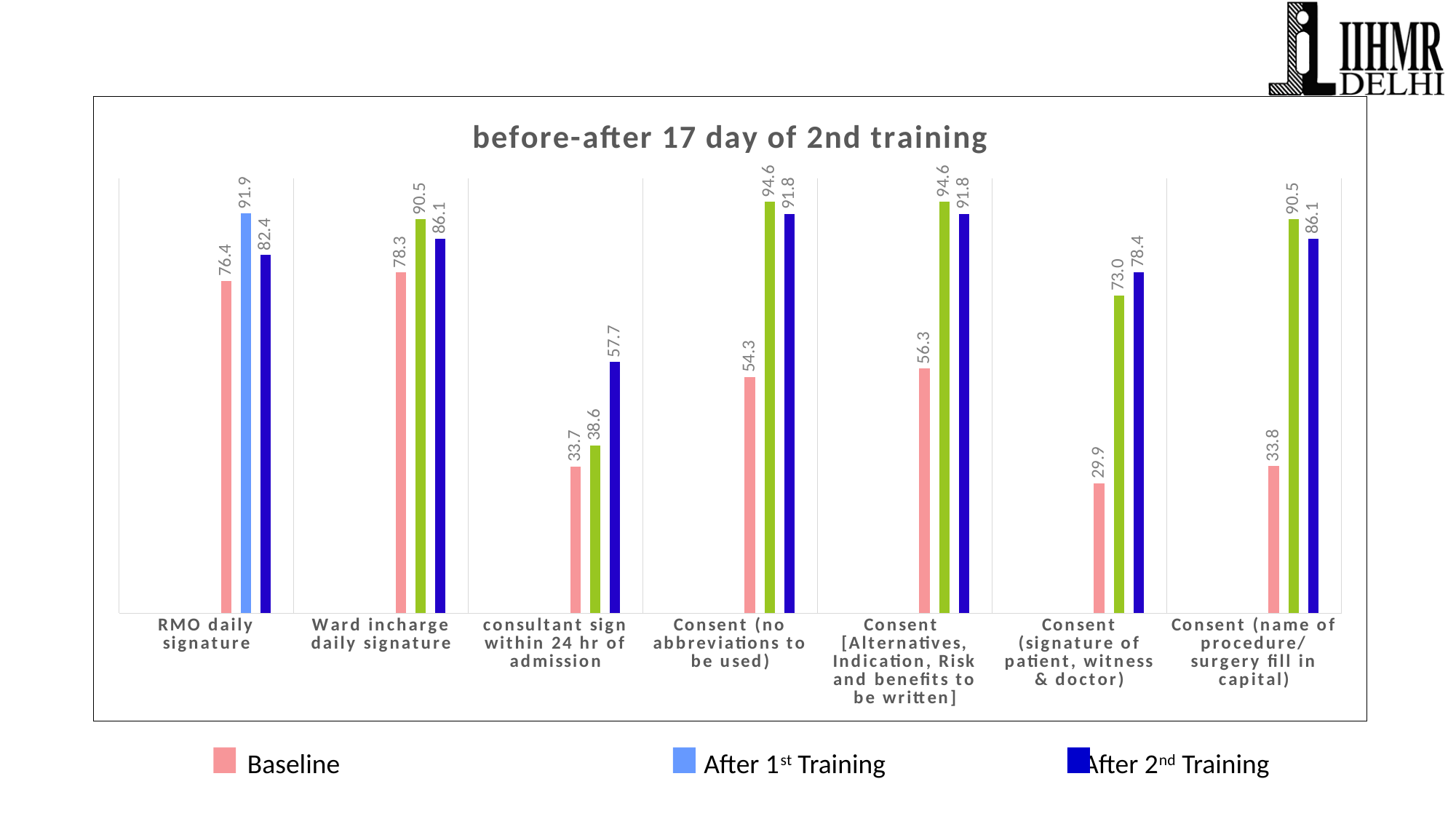
What is the difference between the After 2nd Training value and the Baseline value for Consent (no abbreviations to be used)? 37.5 What is the After 2nd Training value for Consent (name of procedure/surgery fill in capital)? 86.1 Which category has the lowest Baseline value? Consent (signature of patient, witness & doctor) What is the title of the chart? before-after 17 day of 2nd training What is the Baseline value for RMO daily signature? 76.4 How many series does the legend list? 3 What is the Baseline value for Consent (signature of patient, witness & doctor)? 29.9 What kind of chart is shown? Bar chart Which is larger for RMO daily signature: the After 1st Training value or the After 2nd Training value? After 1st Training What is the After 2nd Training value for consultant sign within 24 hr of admission? 57.7 How many categories are shown on the x axis? 7 Which category has the highest Baseline value? Ward incharge daily signature